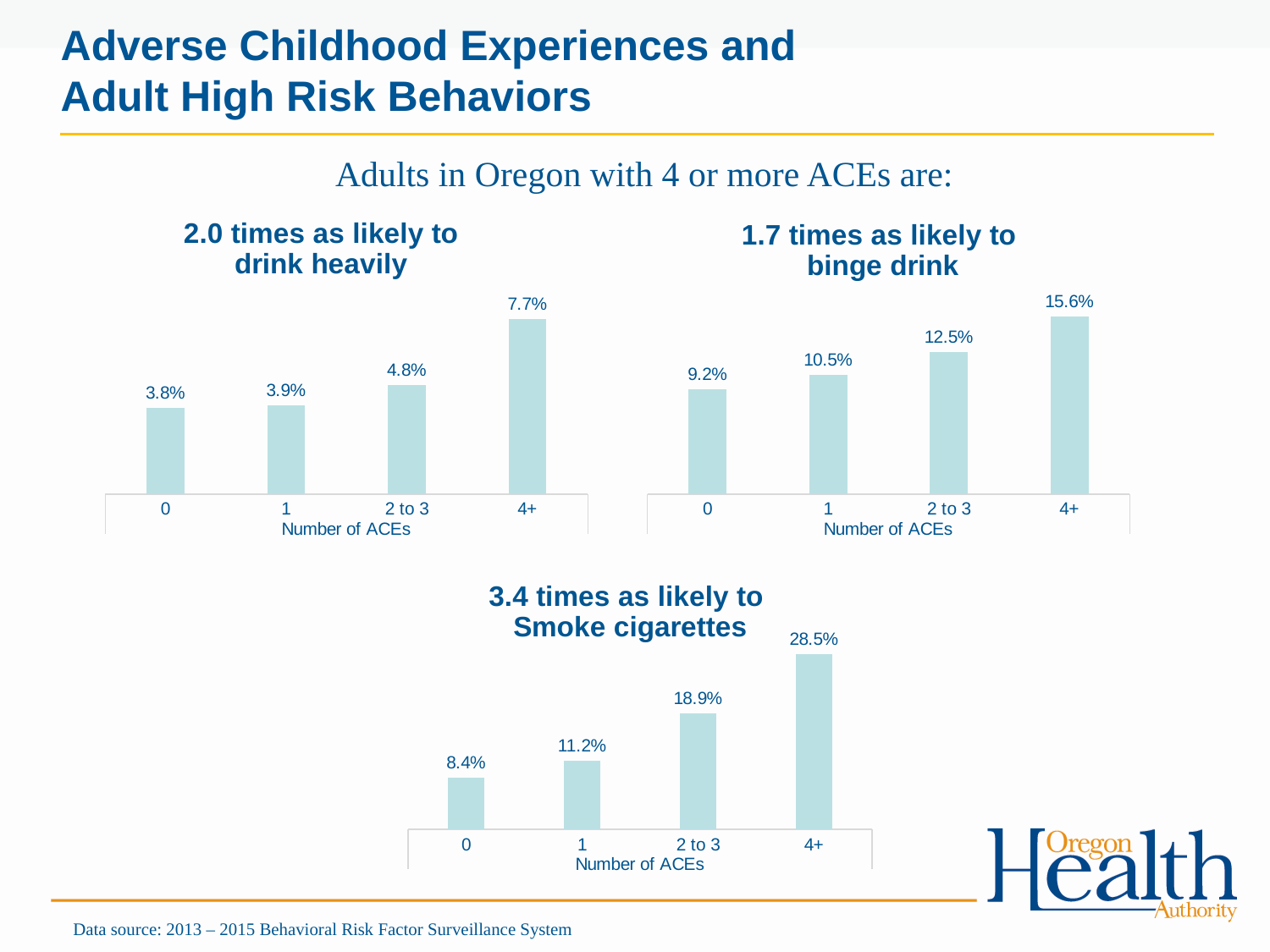
In the 'Smoke cigarettes' chart, what is the value for adults with 2 to 3 ACEs? 18.9% In the 'drink heavily' chart, which is larger: the value for 2 to 3 ACEs or the value for 4+ ACEs? 4+ In the 'binge drink' chart, what is the value for adults with 1 ACE? 10.5% What is the x-axis label on the 'drink heavily' chart? Number of ACEs In the 'Smoke cigarettes' chart, which number of ACEs category has the highest value? 4+ In the 'Smoke cigarettes' chart, do the values rise or fall as the number of ACEs increases? Rise In the 'Smoke cigarettes' chart, what is the difference between the values for 4+ ACEs and 0 ACEs? 20.1% What kind of chart is the 'binge drink' chart? Bar chart In the 'drink heavily' chart, what is the value for adults with 4+ ACEs? 7.7% In the 'binge drink' chart, which number of ACEs category has the lowest value? 0 In the 'binge drink' chart, what is the difference between the values for 2 to 3 ACEs and 1 ACE? 2.0% How many number-of-ACEs categories are shown in the 'drink heavily' chart? 4